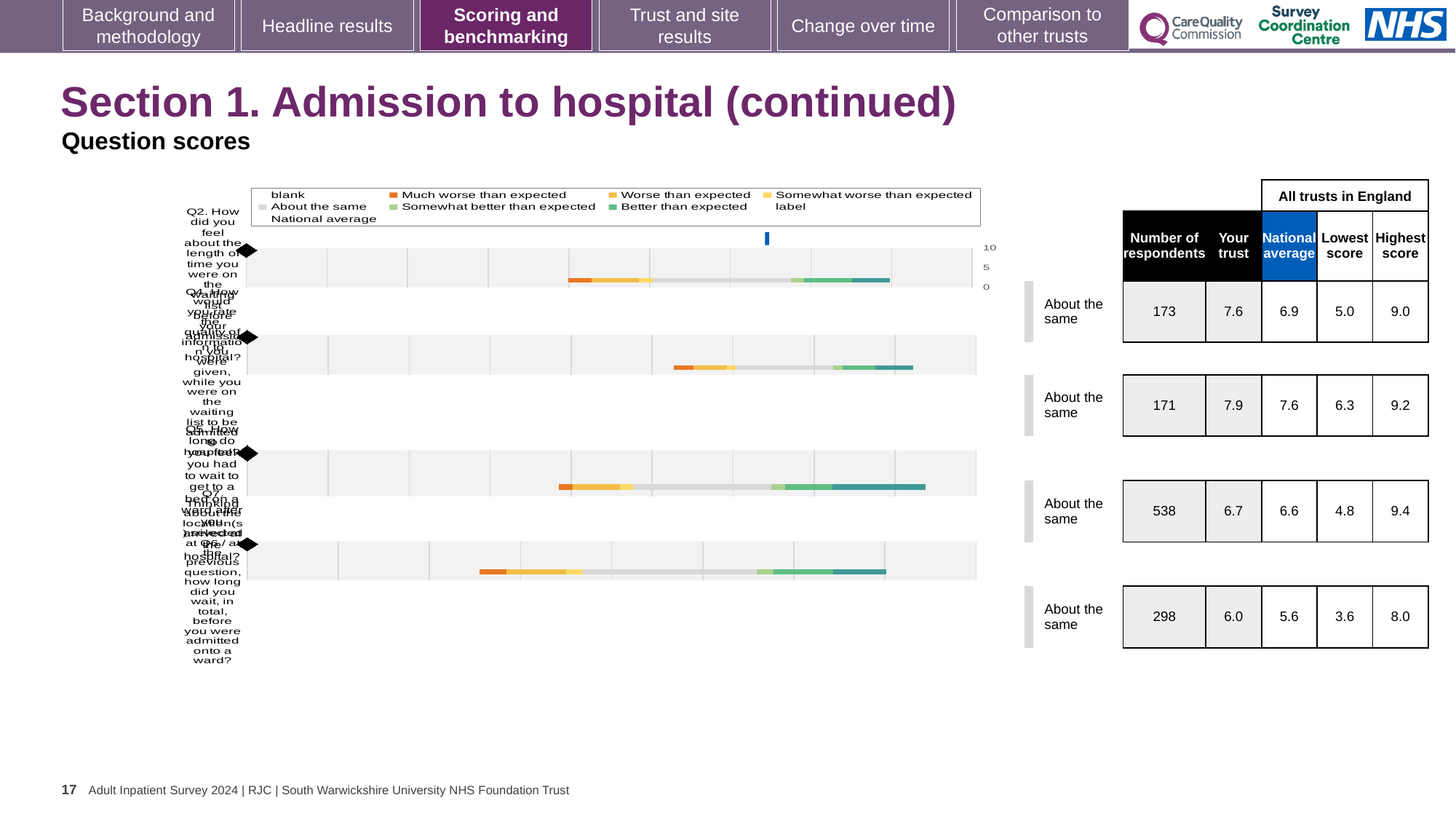
Which legend entry is shown in dark orange? Much worse than expected How many respondents answered Q5 (how long you had to wait to get to a bed on a ward)? 538 What is the 'Your trust' score for Q2 (length of time on the waiting list)? 7.6 Which question has the highest 'Your trust' score? Q4 Which question has the lowest national average score? Q7 What is the difference between the 'Your trust' score and the national average for Q2? 0.7 What is the highest score among all trusts in England for Q5? 9.4 What benchmark category is shown for Q5? About the same What is the lowest score among all trusts in England for Q7 (total wait before being admitted onto a ward)? 3.6 Is the 'Your trust' score for Q7 higher or lower than the national average for Q7? higher What is the national average score for Q4 (quality of information given while on the waiting list)? 7.6 How many questions are plotted on the chart? 4